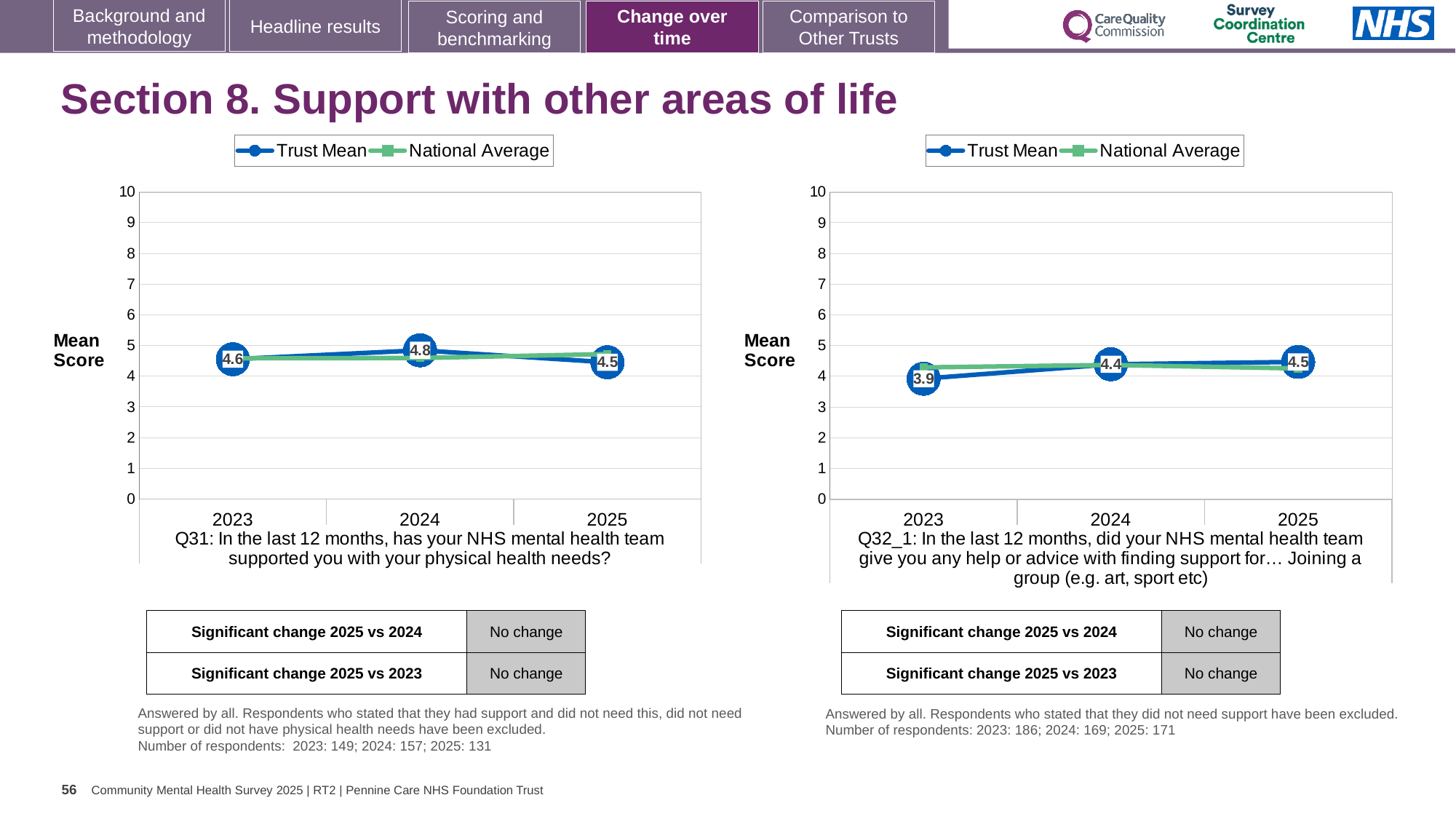
In the Q32_1 chart (right), what is the difference between the Trust Mean for 2025 and 2023? 0.6 In the Q31 chart (left), what is the Trust Mean for 2024? 4.8 In the Q32_1 chart (right), what is the Trust Mean for 2025? 4.5 In the Q32_1 chart (right), which year has the lowest Trust Mean? 2023 How many years are plotted on the x axis of the Q31 chart (left)? 3 What kind of chart is the Q31 chart (left)? line chart In the Q31 chart (left), which year has the highest Trust Mean? 2024 How many series does the legend of the Q32_1 chart (right) list? 2 In the Q31 chart (left), what is the Trust Mean for 2025? 4.5 In the Q31 chart (left), is the Trust Mean for 2024 larger or smaller than the Trust Mean for 2025? larger In the Q32_1 chart (right), what is the Trust Mean for 2023? 3.9 In the Q32_1 chart (right), is the Trust Mean for 2023 greater or less than 5? less